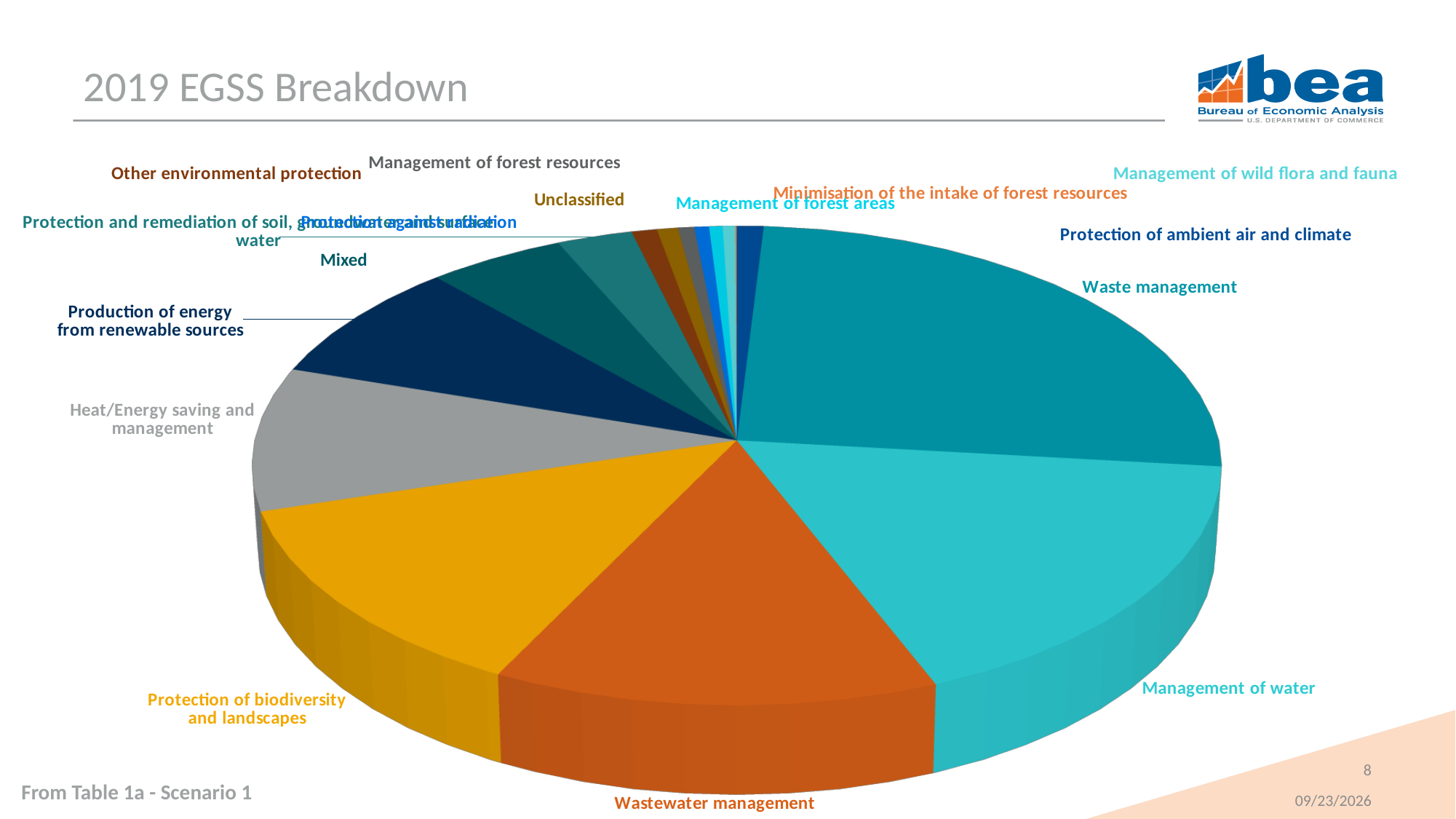
Which slice is larger: Management of water or Production of energy from renewable sources? Management of water Which slice is larger: Protection of biodiversity and landscapes or Mixed? Protection of biodiversity and landscapes What colour is the Wastewater management slice? Orange Which slice is larger: Heat/Energy saving and management or Other environmental protection? Heat/Energy saving and management Which category has the largest slice of the pie? Waste management What kind of chart is shown on the slide? Pie chart What is the title of the slide containing the pie chart? 2019 EGSS Breakdown